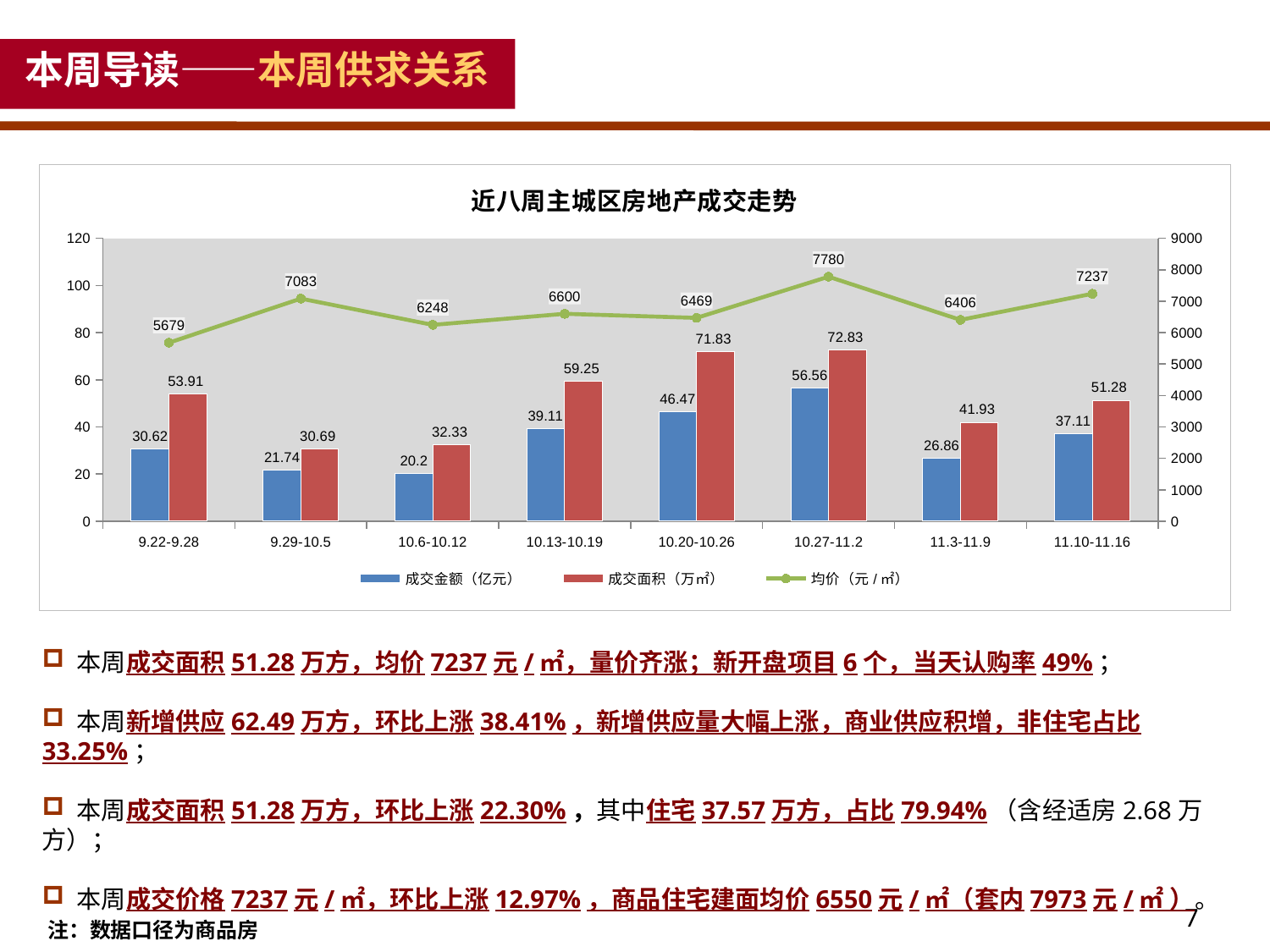
What is the 均价（元/㎡） value for 9.22-9.28? 5679 What is the 成交面积（万㎡） value for 11.10-11.16? 51.28 How many series does the legend list? 3 Which period has the lowest 成交金额（亿元）? 10.6-10.12 What is the 成交金额（亿元） value for 10.27-11.2? 56.56 What is the title of the chart? 近八周主城区房地产成交走势 What is the difference between the 成交面积（万㎡） values for 10.27-11.2 and 10.20-10.26? 1 Does the 均价（元/㎡） line rise or fall from 11.3-11.9 to 11.10-11.16? rise How many periods are shown on the x axis? 8 Which is larger, the 成交金额（亿元） for 10.13-10.19 or for 11.10-11.16? 10.13-10.19 Which period has the highest 均价（元/㎡）? 10.27-11.2 What kind of chart is this? Combined bar and line chart